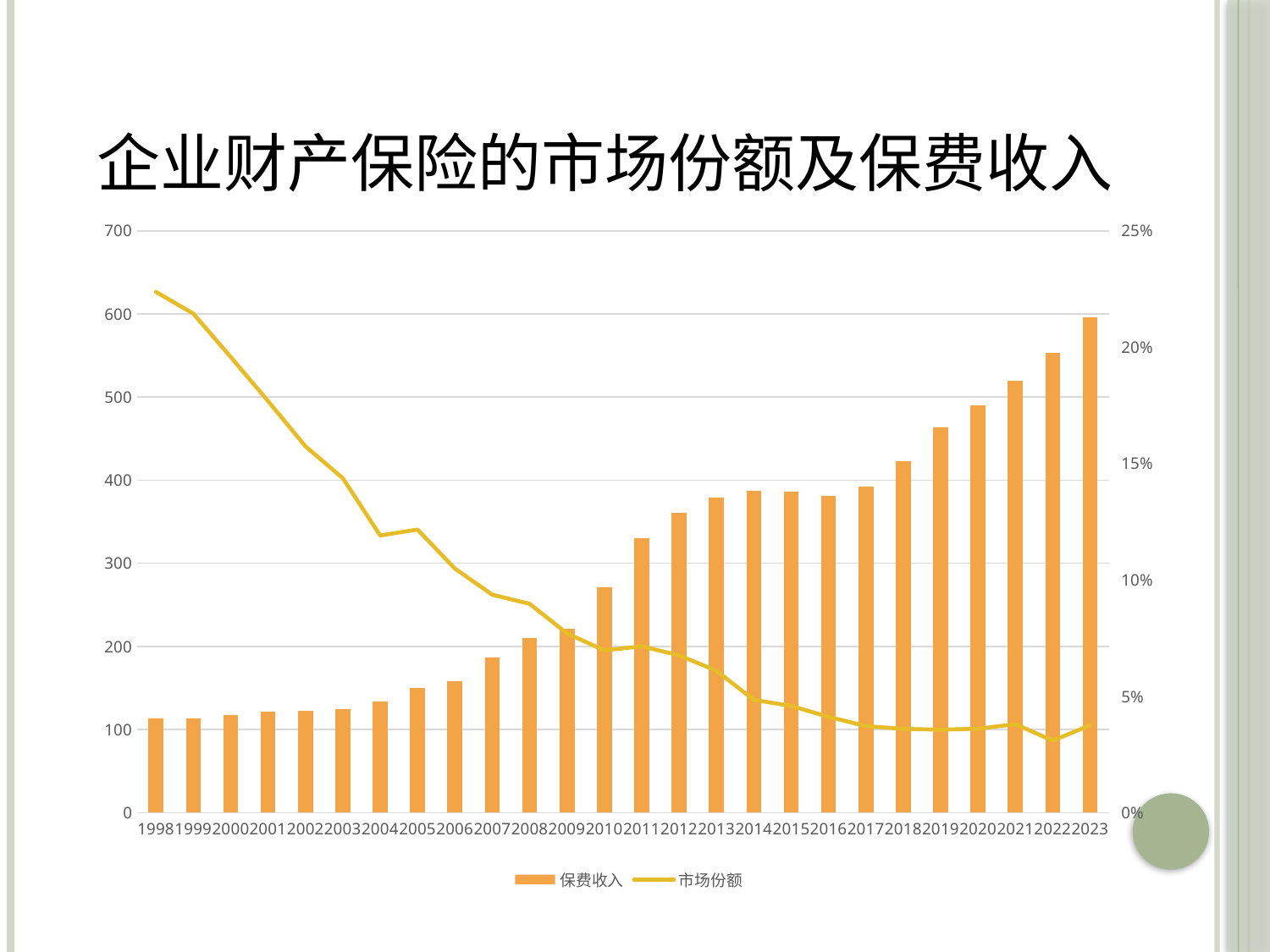
Is the 市场份额 value for 1998 greater or less than 20%? greater How many years are shown on the x axis? 26 Do the 保费收入 bars rise or fall overall from 1998 to 2023? Rise How many series does the legend list? 2 Does the 市场份额 line rise or fall overall from 1998 to 2023? Fall Is the 市场份额 value for 2022 greater or less than 5%? less What is the title of the chart? 企业财产保险的市场份额及保费收入 What kind of chart is shown on the slide? A combined bar and line chart Which year has the larger 保费收入 bar, 2010 or 2013? 2013 Is the 保费收入 value for 2010 greater or less than 300? less Which year has the highest 保费收入 bar? 2023